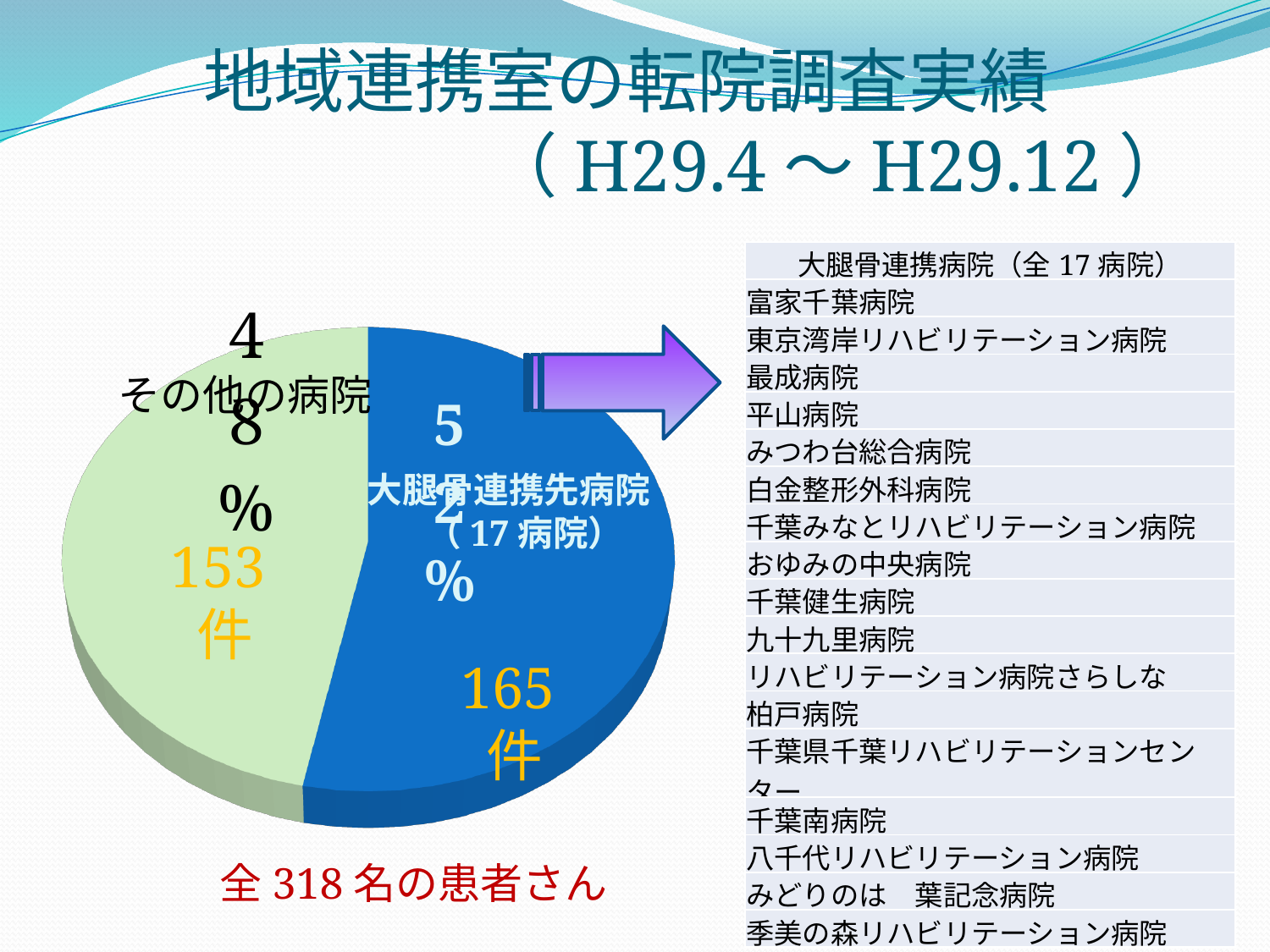
Which category has the smallest slice in the pie chart? その他の病院 What colour is the slice for 大腿骨連携先病院（17病院）? blue What percentage share of the pie does その他の病院 have? 48% Which slice of the pie chart is larger, その他の病院 or 大腿骨連携先病院（17病院）? 大腿骨連携先病院（17病院） What is the total number of patients represented by the pie chart, as stated below it? 318名 How many slices does the pie chart have? 2 What is the difference in cases between 大腿骨連携先病院（17病院） and その他の病院? 12件 What percentage share of the pie does 大腿骨連携先病院（17病院） have? 52% What period does the chart title say the data covers? H29.4～H29.12 What kind of chart is shown on the slide? pie chart How many cases (件) are shown for その他の病院? 153件 How many cases (件) are shown for 大腿骨連携先病院（17病院）? 165件